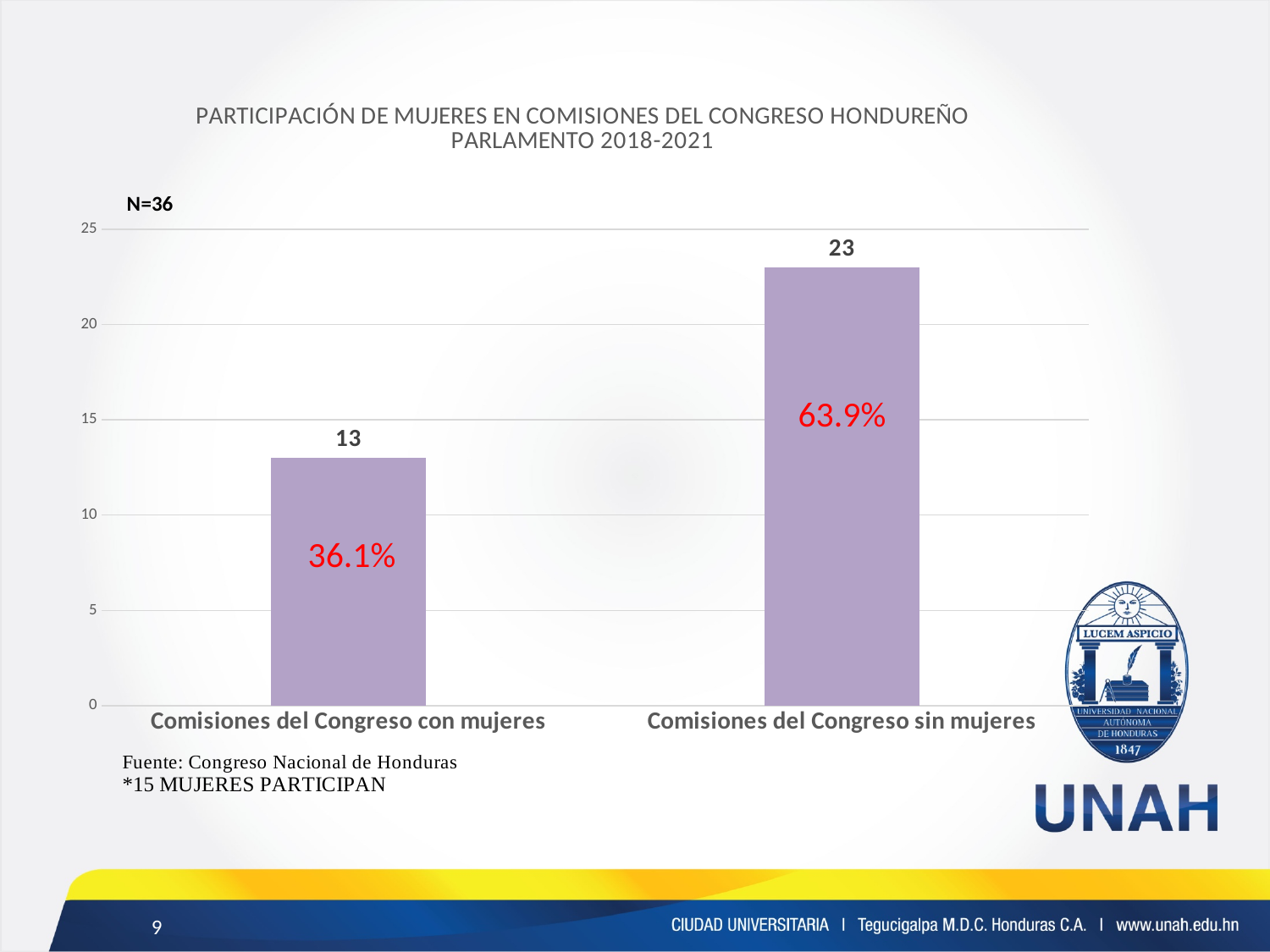
What kind of chart is shown on the slide? bar chart Is the value for Comisiones del Congreso sin mujeres greater or less than 20? greater What percentage is shown on the bar for Comisiones del Congreso con mujeres? 36.1% Which category has the highest value? Comisiones del Congreso sin mujeres Which category has the lowest value? Comisiones del Congreso con mujeres What is the value for Comisiones del Congreso sin mujeres? 23 What is the value for Comisiones del Congreso con mujeres? 13 What percentage is shown on the bar for Comisiones del Congreso sin mujeres? 63.9% How many categories are shown in the chart? 2 Which is larger: the value for Comisiones del Congreso con mujeres or for Comisiones del Congreso sin mujeres? Comisiones del Congreso sin mujeres What is the difference between the values for Comisiones del Congreso sin mujeres and Comisiones del Congreso con mujeres? 10 What is the N value shown above the chart? N=36